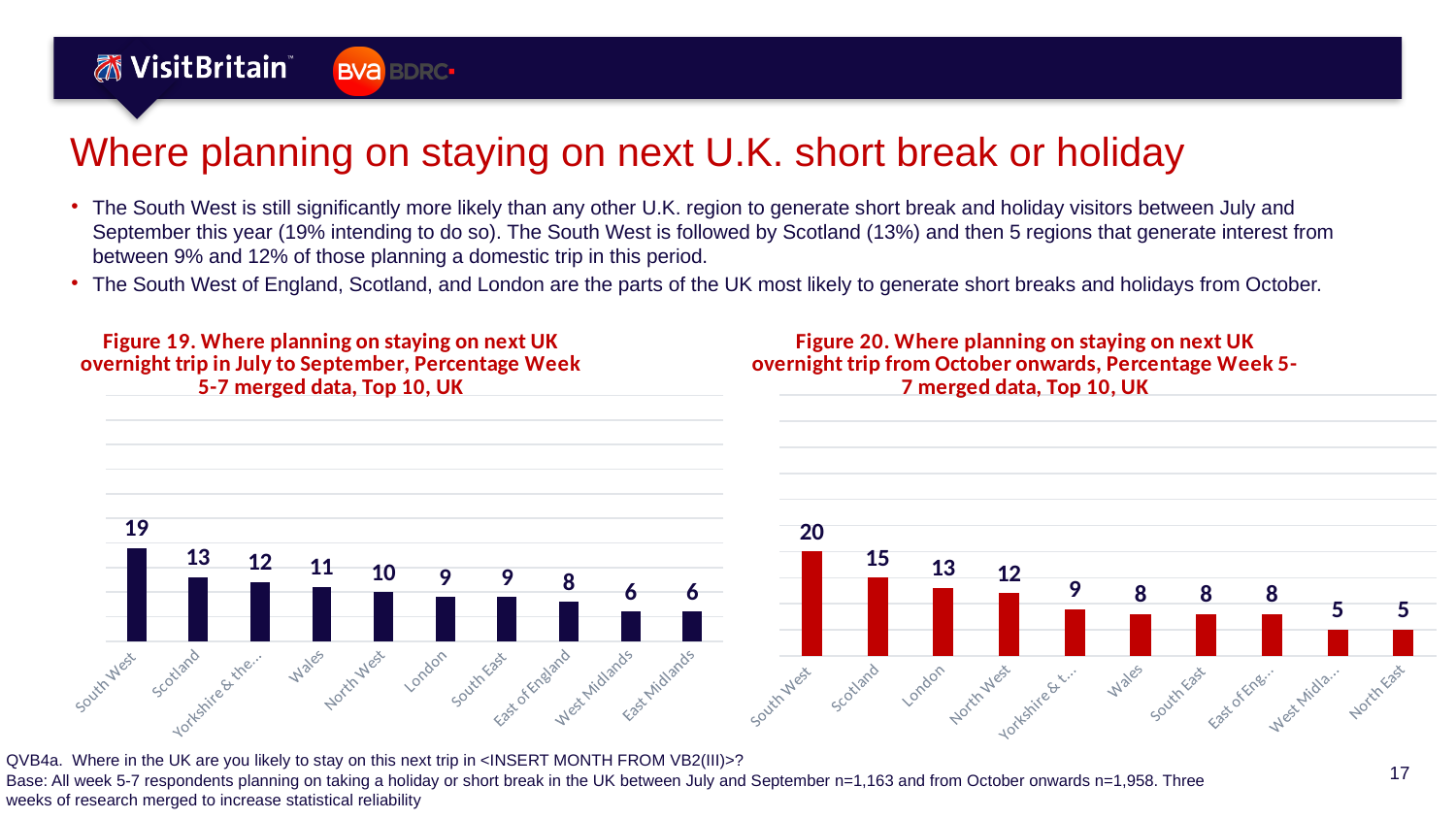
In Figure 20 (October onwards), what is the difference between South West and Scotland? 5 In Figure 19 (July to September), which is larger, the value for Scotland or the value for North West? Scotland In Figure 19 (July to September), what is the difference between South West and Scotland? 6 In Figure 20 (October onwards), which region has the highest value? South West In Figure 19 (July to September), which region has the highest value? South West How many regions are shown in Figure 19 (July to September)? 10 In Figure 19 (July to September), what is the value for South West? 19 In Figure 20 (October onwards), do the values rise or fall from left to right along the x axis? Fall In Figure 20 (October onwards), what is the value for Scotland? 15 In Figure 19 (July to September), what is the value for Wales? 11 In Figure 20 (October onwards), which is larger, the value for London or the value for North West? London What kind of chart is Figure 20 (October onwards)? Bar chart